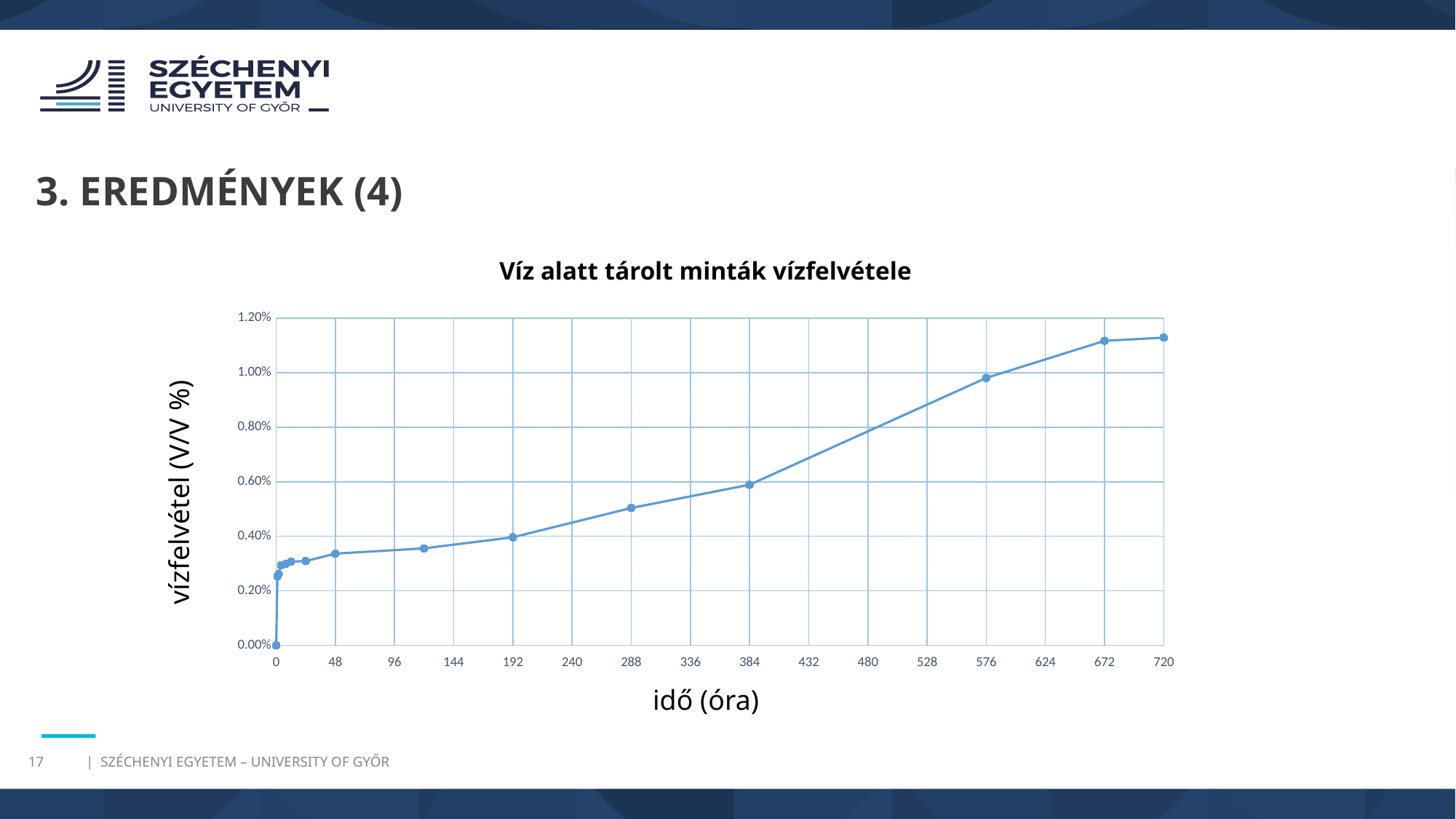
Is the water uptake at 576 hours greater or less than 0.80%? greater What is the water uptake value at 0 hours? 0.00% Do the values rise or fall as time increases along the x axis? rise At which time (in hours) is the water uptake lowest? 0 Which has the larger water uptake: 576 hours or 384 hours? 576 hours Is the water uptake at 48 hours greater or less than 0.40%? less What kind of chart is shown on the slide? line chart At which time (in hours) is the water uptake highest? 720 What is the label of the x axis? idő (óra) Is the water uptake at 720 hours greater or less than 1.00%? greater What is the title of the chart? Víz alatt tárolt minták vízfelvétele